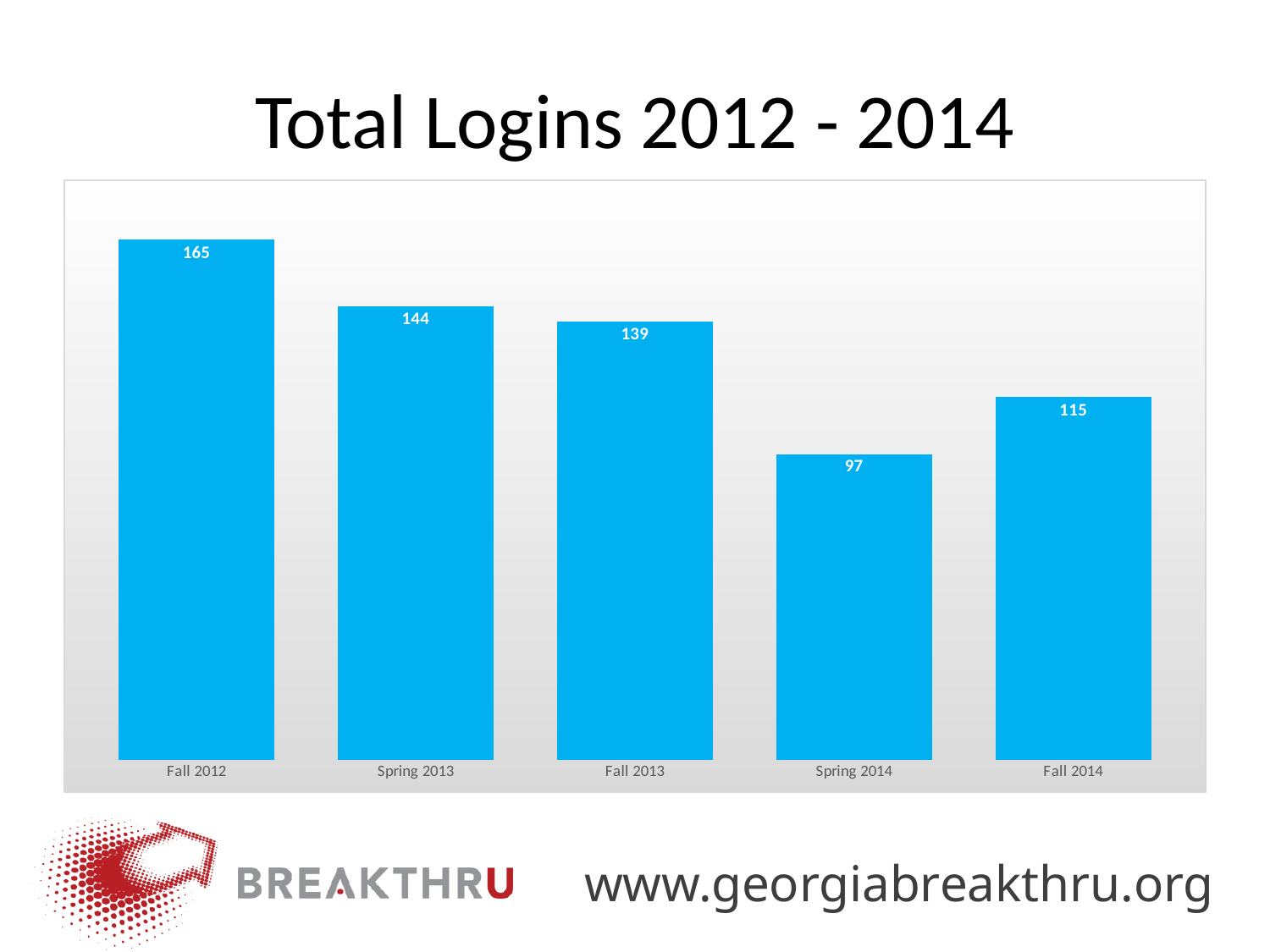
What kind of chart is shown on the slide? bar chart Which category has the highest value? Fall 2012 How many categories are shown on the x axis? 5 What is the value for Spring 2014? 97 Do the values rise or fall from Fall 2012 to Spring 2014? fall What is the title of the chart? Total Logins 2012 - 2014 What is the difference between the values for Fall 2014 and Spring 2014? 18 Which is larger, the value for Spring 2013 or the value for Fall 2013? Spring 2013 Which category has the lowest value? Spring 2014 What is the value for Fall 2012? 165 What is the difference between the values for Fall 2012 and Spring 2013? 21 What is the value for Fall 2014? 115